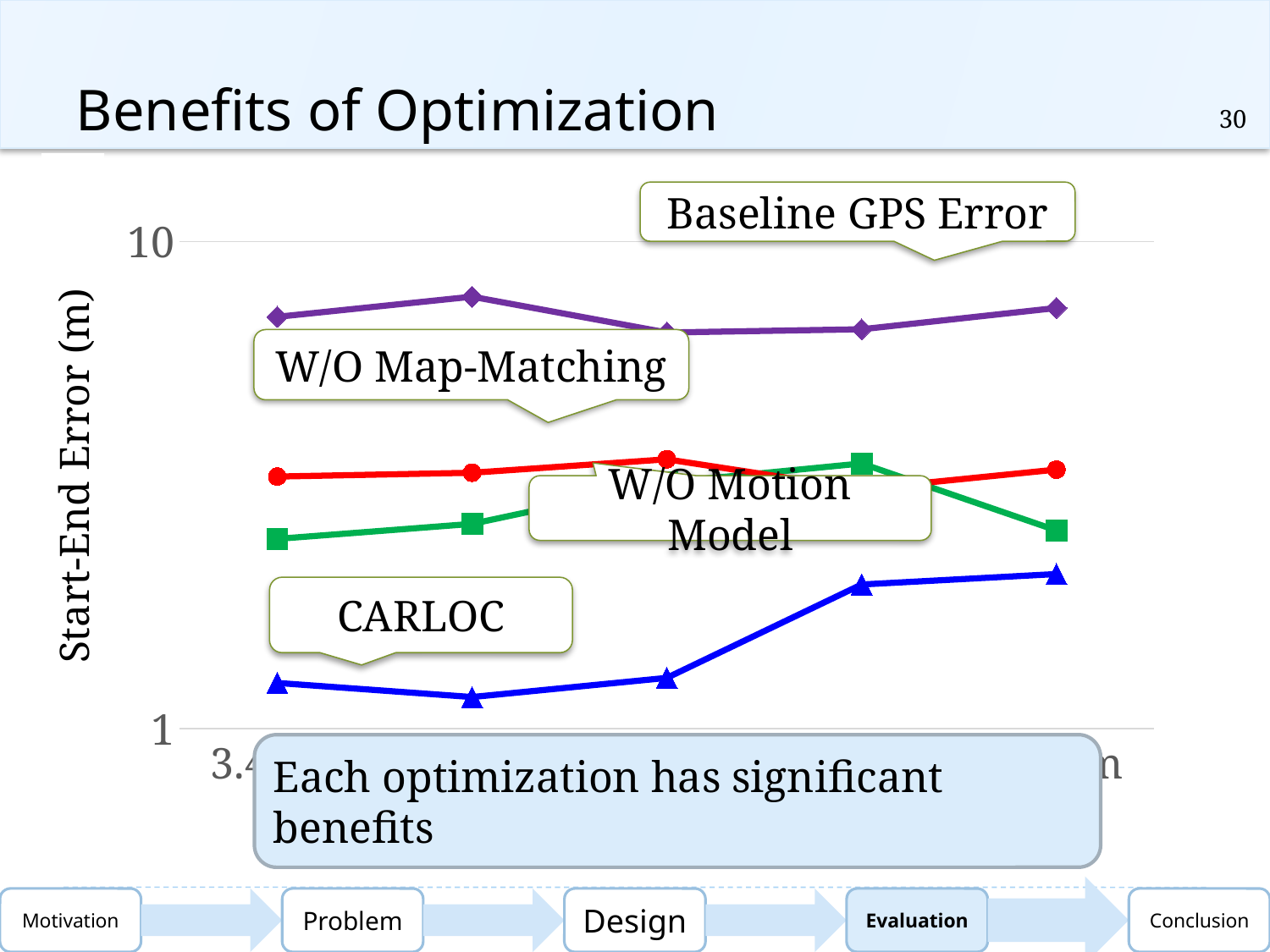
At the last point, which is larger: W/O Map-Matching or CARLOC? W/O Map-Matching How many series (lines) are plotted on the chart? 4 What kind of chart is shown on the slide? line chart Which series has the lowest Start-End Error across the chart? CARLOC Which series is drawn with purple diamond markers? Baseline GPS Error At the first point, which is larger: W/O Map-Matching or W/O Motion Model? W/O Map-Matching Does the CARLOC line generally rise or fall from left to right? rise Is the value for CARLOC at the last point greater or less than 1? greater How many data points does each line on the chart have? 5 Is the value for Baseline GPS Error at the first point greater or less than 10? less What is the label of the y axis? Start-End Error (m) Which series has the highest Start-End Error across the chart? Baseline GPS Error